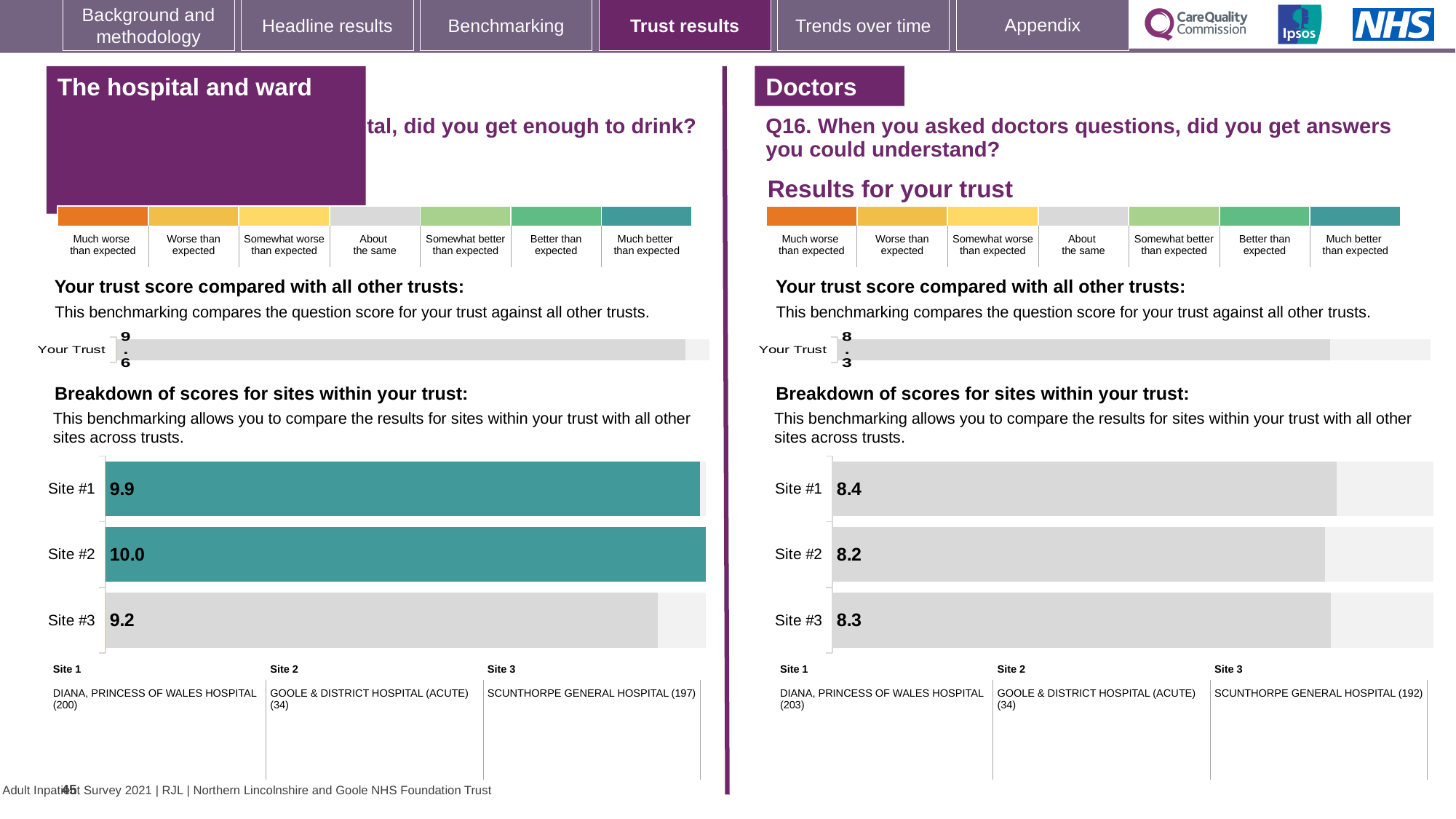
In the Doctors Q16 site breakdown chart, what is the score for Site #1? 8.4 In the left-hand site breakdown chart (the 'did you get enough to drink?' question), what is the difference between the scores for Site #2 and Site #3? 0.8 In the Doctors Q16 site breakdown chart, which site has the lowest score? Site #2 In the left-hand 'Your trust score compared with all other trusts' chart (the 'did you get enough to drink?' question), what is the score for Your Trust? 9.6 How many sites are shown in the Doctors Q16 site breakdown chart? 3 In the left-hand site breakdown chart (the 'did you get enough to drink?' question), which site has the lowest score? Site #3 In the Doctors Q16 'Your trust score compared with all other trusts' chart, what is the score for Your Trust? 8.3 In the Doctors Q16 site breakdown chart, what is the difference between the scores for Site #1 and Site #2? 0.2 In the left-hand site breakdown chart (the 'did you get enough to drink?' question), what is the score for Site #3? 9.2 In the left-hand site breakdown chart (the 'did you get enough to drink?' question), what is the score for Site #2? 10.0 In the left-hand site breakdown chart (the 'did you get enough to drink?' question), which site has the highest score? Site #2 What type of chart is used for the site breakdown on the Doctors Q16 side of the slide? Bar chart